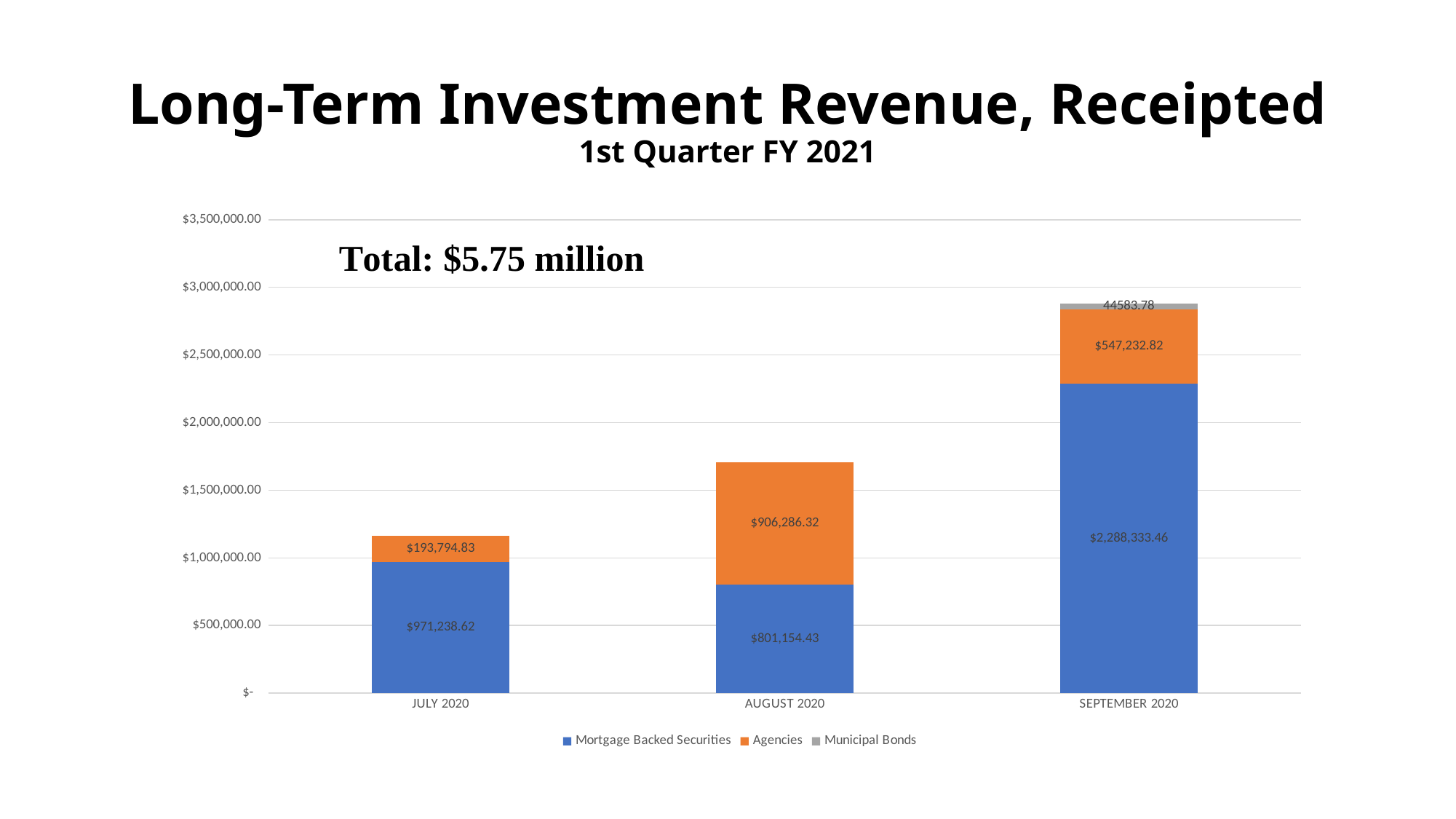
Which month has the lowest Agencies value? July 2020 Which month has the highest Mortgage Backed Securities value? September 2020 What is the difference between the Mortgage Backed Securities values for September 2020 and July 2020? $1,317,094.84 What is the value of Agencies for July 2020? $193,794.83 What is the total of the stacked bar for August 2020? $1,707,440.75 What is the value of Municipal Bonds for September 2020? 44583.78 What is the value of Agencies for August 2020? $906,286.32 Which is larger for August 2020: Mortgage Backed Securities or Agencies? Agencies What type of chart is shown on the slide? Stacked bar chart How many series does the legend list? 3 What is the value of Mortgage Backed Securities for September 2020? $2,288,333.46 Is the total for September 2020 greater or less than $2,500,000.00? greater